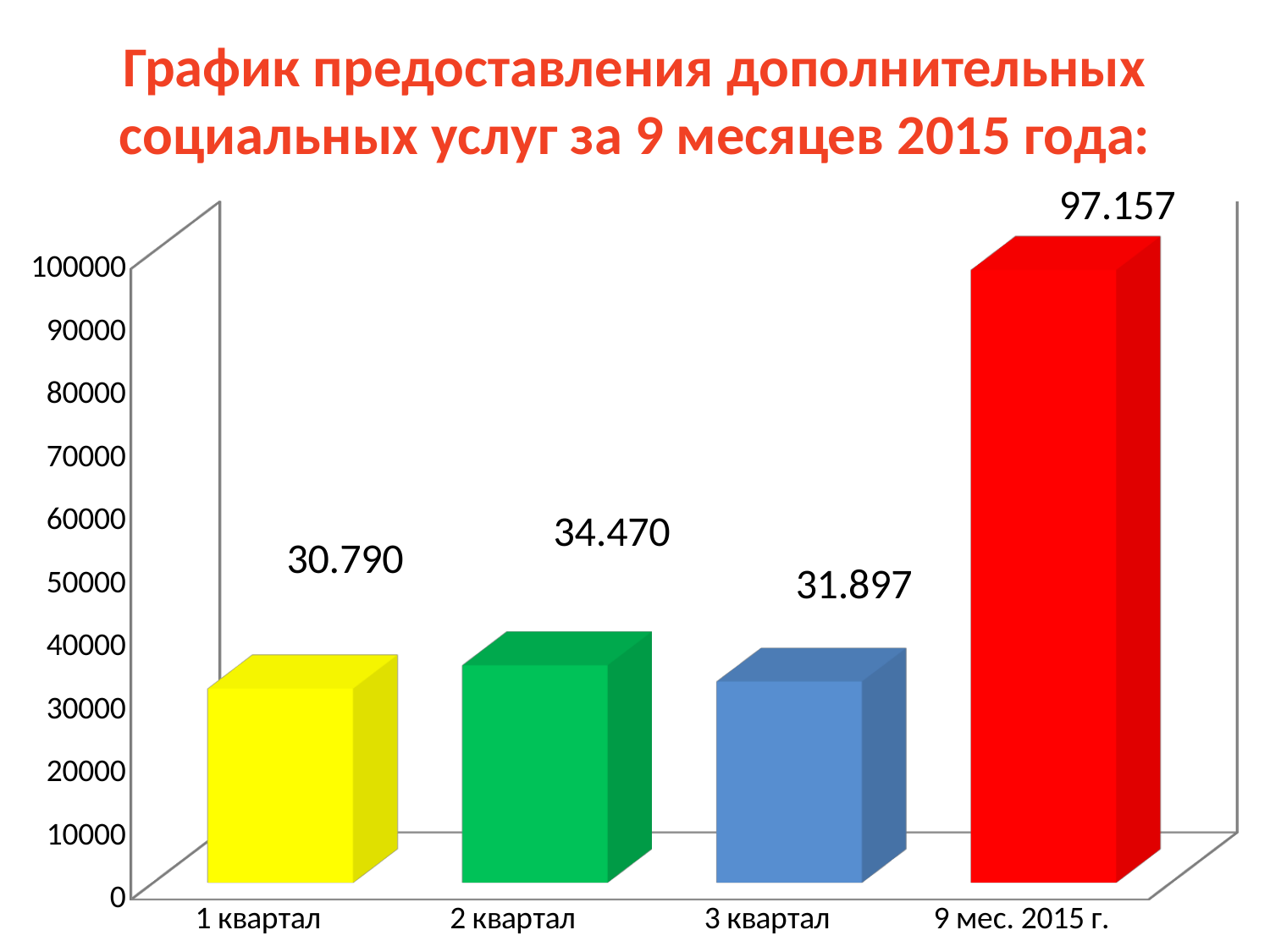
Which category has the lowest value? 1 квартал What colour is the bar for 9 мес. 2015 г.? red How many categories are shown on the x axis? 4 What is the value for 1 квартал? 30.790 What is the value for 3 квартал? 31.897 What is the difference between the values for 2 квартал and 1 квартал? 3.680 What is the value for 9 мес. 2015 г.? 97.157 What is the value for 2 квартал? 34.470 Which is larger, the value for 2 квартал or the value for 3 квартал? 2 квартал Is the value for 9 мес. 2015 г. greater or less than 90000? greater Which category has the highest value? 9 мес. 2015 г. What kind of chart is shown on the slide? bar chart